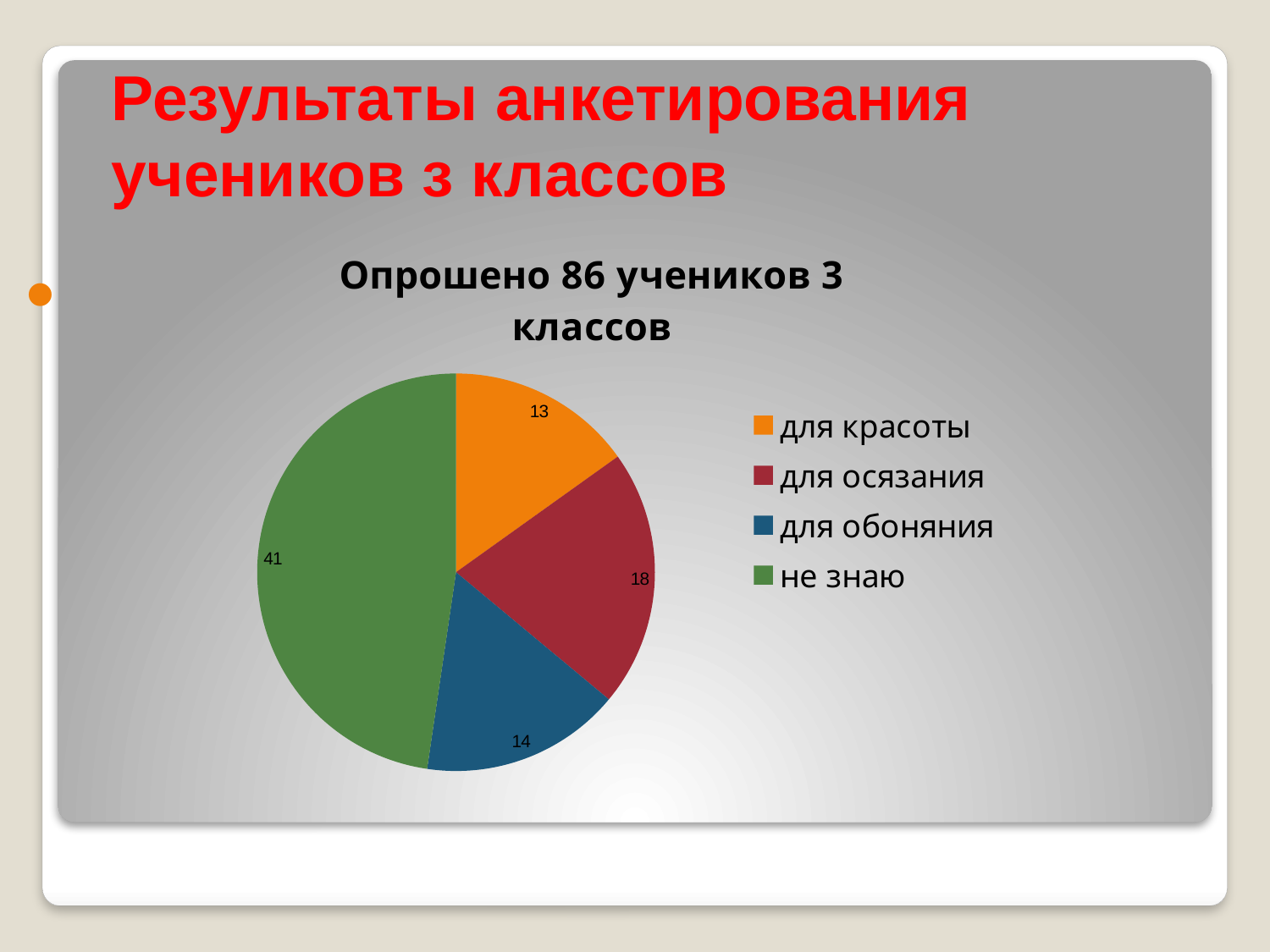
Which category has the largest slice? не знаю What is the value for "для обоняния"? 14 How many slices does the pie chart have? 4 Which category has the smallest slice? для красоты What is the difference between the values for "не знаю" and "для осязания"? 23 What is the value for "для красоты"? 13 What is the value for "для осязания"? 18 What kind of chart is shown on the slide? pie chart How many entries does the legend list? 4 What is the value for "не знаю"? 41 Which colour represents "для обоняния" in the chart? blue What is the title of the chart? Опрошено 86 учеников 3 классов